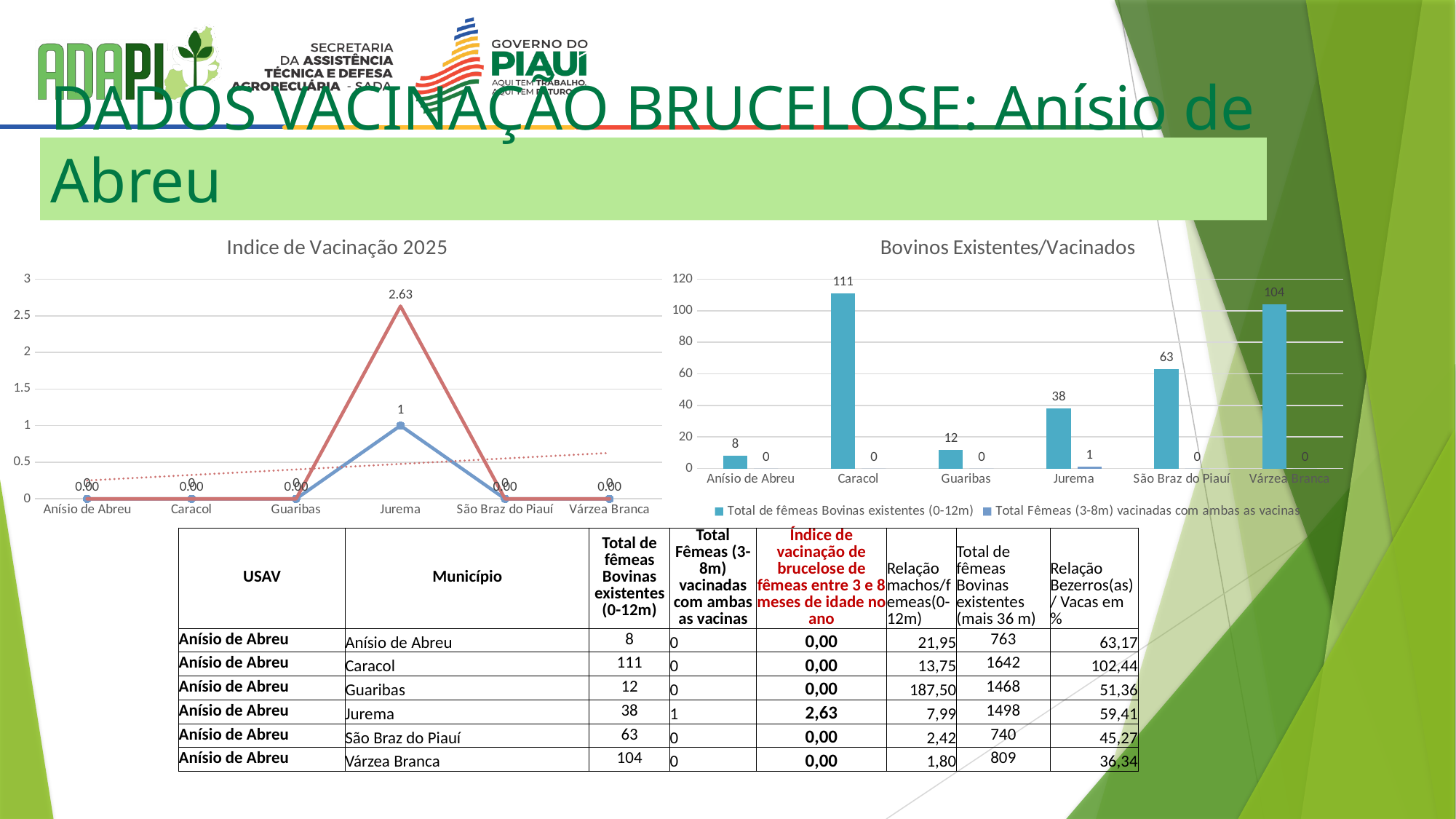
In the 'Bovinos Existentes/Vacinados' chart, what is the difference between the 'Total de fêmeas Bovinas existentes (0-12m)' values for Caracol and São Braz do Piauí? 48 How many series does the legend of the 'Bovinos Existentes/Vacinados' chart list? 2 In the 'Bovinos Existentes/Vacinados' chart, what is the value of 'Total Fêmeas (3-8m) vacinadas com ambas as vacinas' for Jurema? 1 In the 'Bovinos Existentes/Vacinados' chart, what is the value of 'Total de fêmeas Bovinas existentes (0-12m)' for Caracol? 111 In the 'Bovinos Existentes/Vacinados' chart, which municipality has the lowest value for 'Total de fêmeas Bovinas existentes (0-12m)'? Anísio de Abreu In the 'Indice de Vacinação 2025' chart, what is the highest value shown on the red line, and for which municipality? 2.63, Jurema In the 'Bovinos Existentes/Vacinados' chart, which municipality has the highest value for 'Total de fêmeas Bovinas existentes (0-12m)'? Caracol What kind of chart is 'Indice de Vacinação 2025'? Line chart What kind of chart is 'Bovinos Existentes/Vacinados'? Bar chart How many municipalities are shown on the x axis of the 'Indice de Vacinação 2025' chart? 6 In the 'Bovinos Existentes/Vacinados' chart, which is larger: the 'Total de fêmeas Bovinas existentes (0-12m)' value for Jurema or for Guaribas? Jurema In the 'Bovinos Existentes/Vacinados' chart, what is the value of 'Total de fêmeas Bovinas existentes (0-12m)' for Várzea Branca? 104